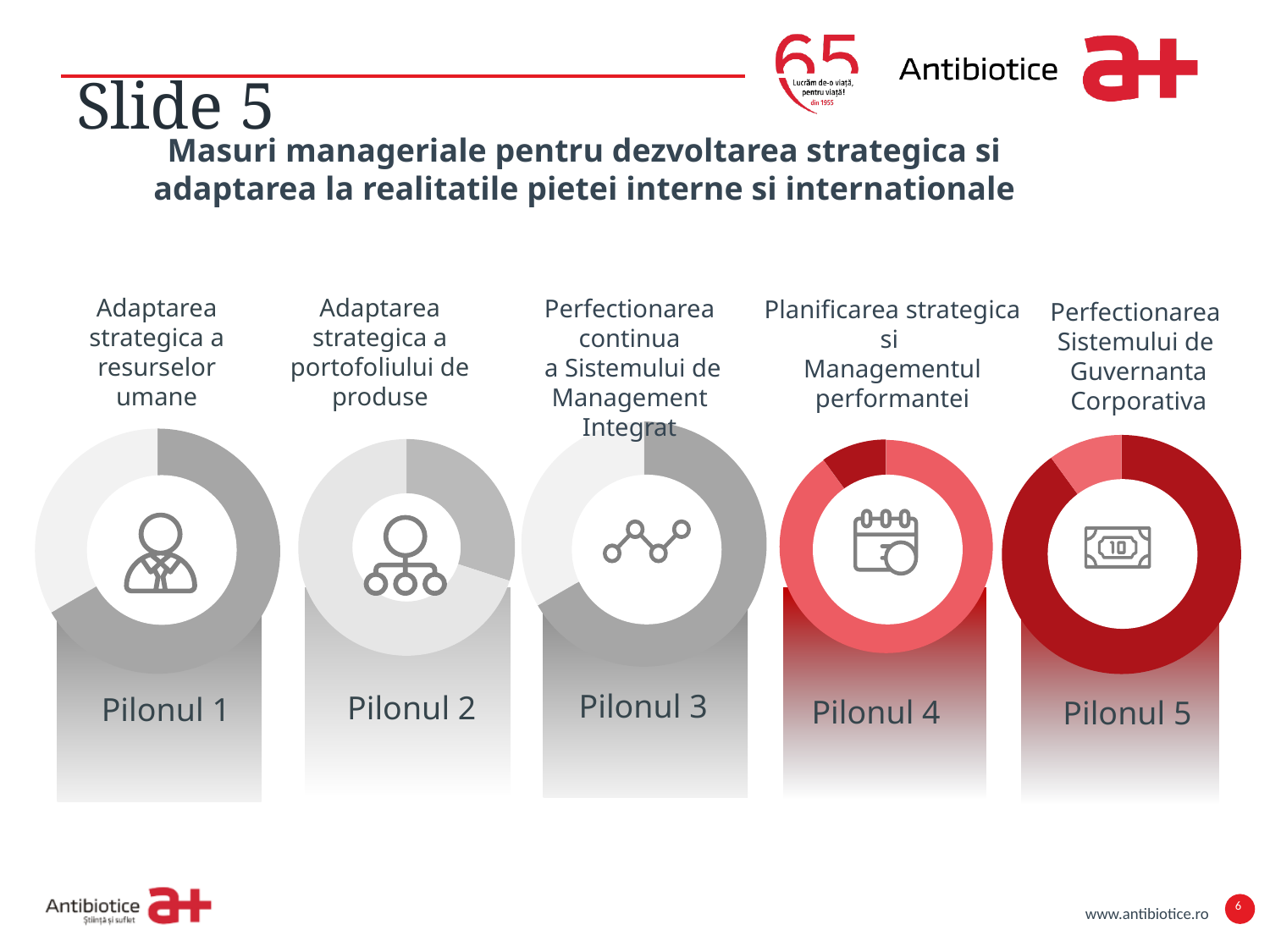
In the donut chart for Pilonul 4, which slice is larger, the light red one or the dark red one? light red In the donut chart for Pilonul 1, which slice is larger, the dark gray one or the light gray one? dark gray How many slices does the donut chart for Pilonul 1 have? 2 In the donut chart for Pilonul 5, which slice is larger, the dark red one or the light red one? dark red How many donut charts are shown on the slide? 5 What kind of chart is shown under the label Pilonul 4? donut chart Which pillar label appears under the third donut chart from the left? Pilonul 3 What kind of chart is shown under the label Pilonul 1? donut chart Which donut charts on the slide are coloured red rather than gray? Pilonul 4 and Pilonul 5 How many slices does the donut chart for Pilonul 5 have? 2